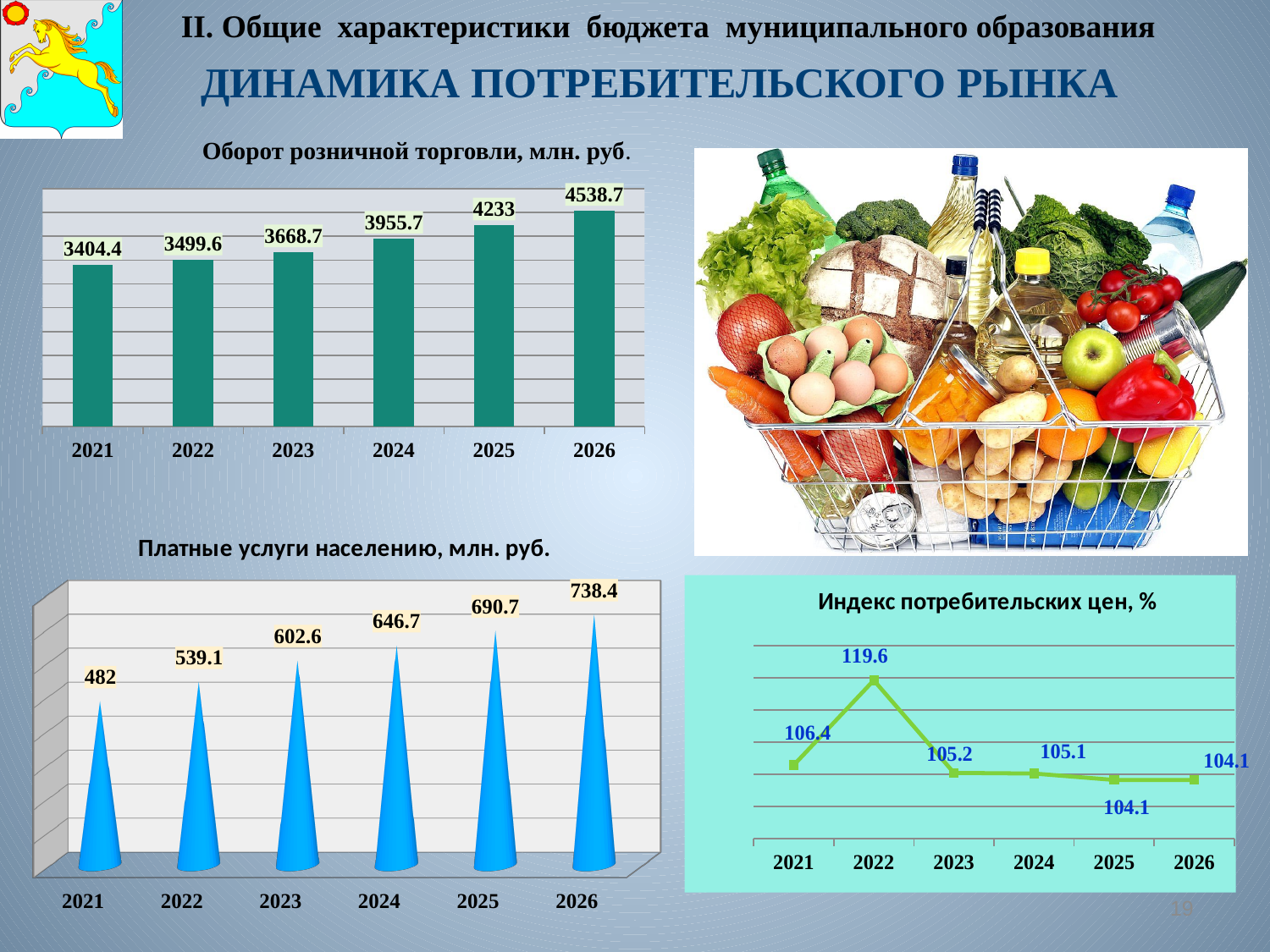
In the chart 'Оборот розничной торговли, млн. руб.', which year has the highest value? 2026 In the chart 'Индекс потребительских цен, %', what is the value for 2022? 119.6 In the chart 'Оборот розничной торговли, млн. руб.', do the values rise or fall from 2021 to 2026? rise In the chart 'Платные услуги населению, млн. руб.', which year has the lowest value? 2021 In the chart 'Оборот розничной торговли, млн. руб.', what is the difference between the 2026 and 2021 values? 1134.3 In the chart 'Индекс потребительских цен, %', which is larger: the value for 2021 or the value for 2023? 2021 In the chart 'Платные услуги населению, млн. руб.', what is the difference between the 2025 and 2024 values? 44 In the chart 'Платные услуги населению, млн. руб.', how many years are shown on the x axis? 6 In the chart 'Индекс потребительских цен, %', which year has the highest value? 2022 In the chart 'Платные услуги населению, млн. руб.', what is the value for 2023? 602.6 What kind of chart is 'Оборот розничной торговли, млн. руб.'? bar chart In the chart 'Оборот розничной торговли, млн. руб.', what is the value for 2024? 3955.7